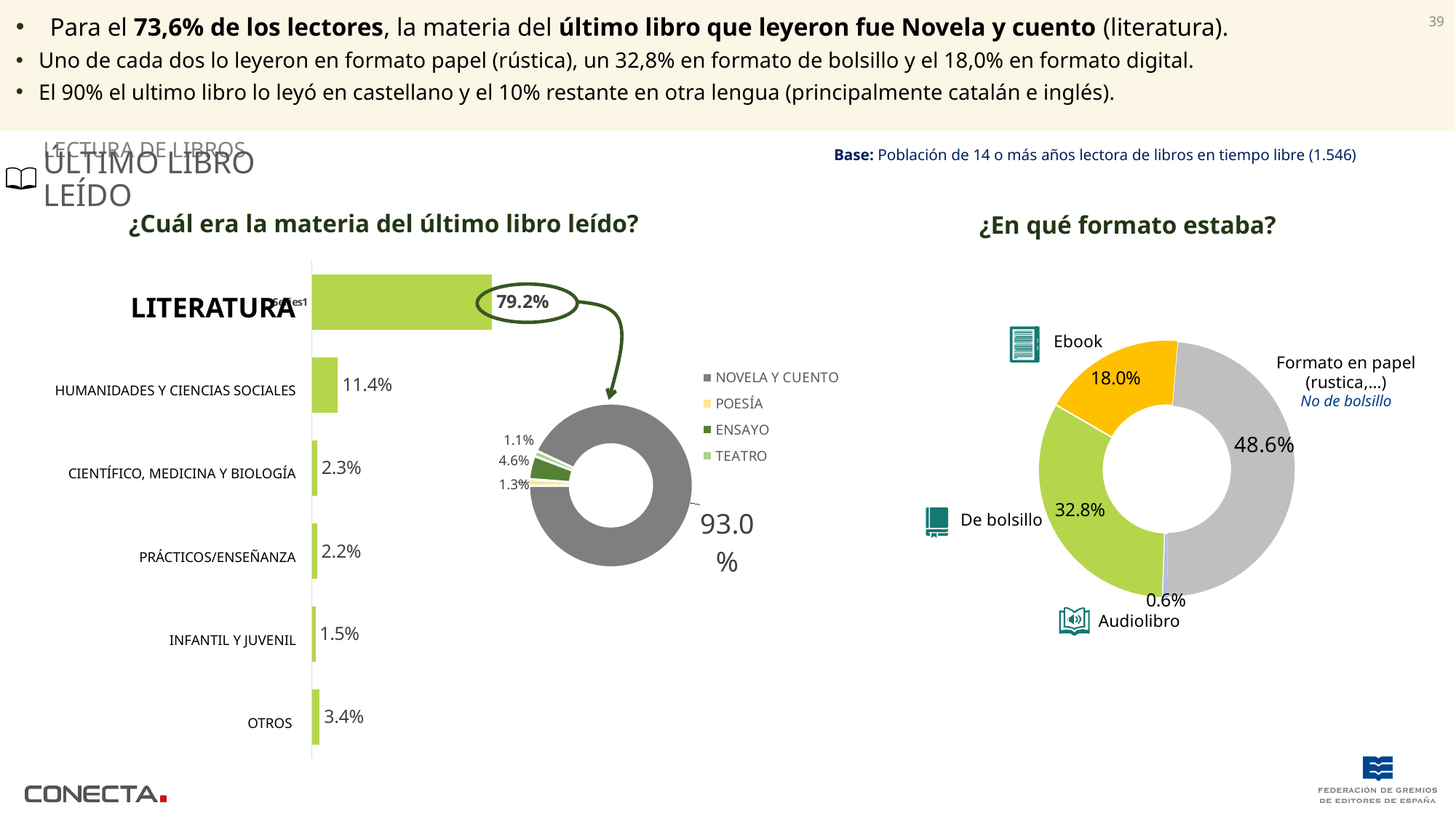
How many categories are shown in the bar chart '¿Cuál era la materia del último libro leído?'? 6 In the chart '¿Cuál era la materia del último libro leído?', what is the value for LITERATURA? 79.2% In the chart '¿Cuál era la materia del último libro leído?', what is the value for HUMANIDADES Y CIENCIAS SOCIALES? 11.4% In the chart '¿En qué formato estaba?', which format has the largest share? Formato en papel (rustica,...) In the chart '¿En qué formato estaba?', what is the value for Ebook? 18.0% What type of chart is '¿Cuál era la materia del último libro leído?'? Bar chart In the chart '¿Cuál era la materia del último libro leído?', what is the difference between LITERATURA and HUMANIDADES Y CIENCIAS SOCIALES? 67.8 percentage points In the chart '¿Cuál era la materia del último libro leído?', which is larger: OTROS or CIENTÍFICO, MEDICINA Y BIOLOGÍA? OTROS In the chart '¿Cuál era la materia del último libro leído?', which category has the lowest value? INFANTIL Y JUVENIL In the small donut chart breaking down LITERATURA, what share does NOVELA Y CUENTO have? 93.0% In the chart '¿En qué formato estaba?', what is the difference between De bolsillo and Ebook? 14.8 percentage points How many entries does the legend of the small donut chart breaking down LITERATURA list? 4